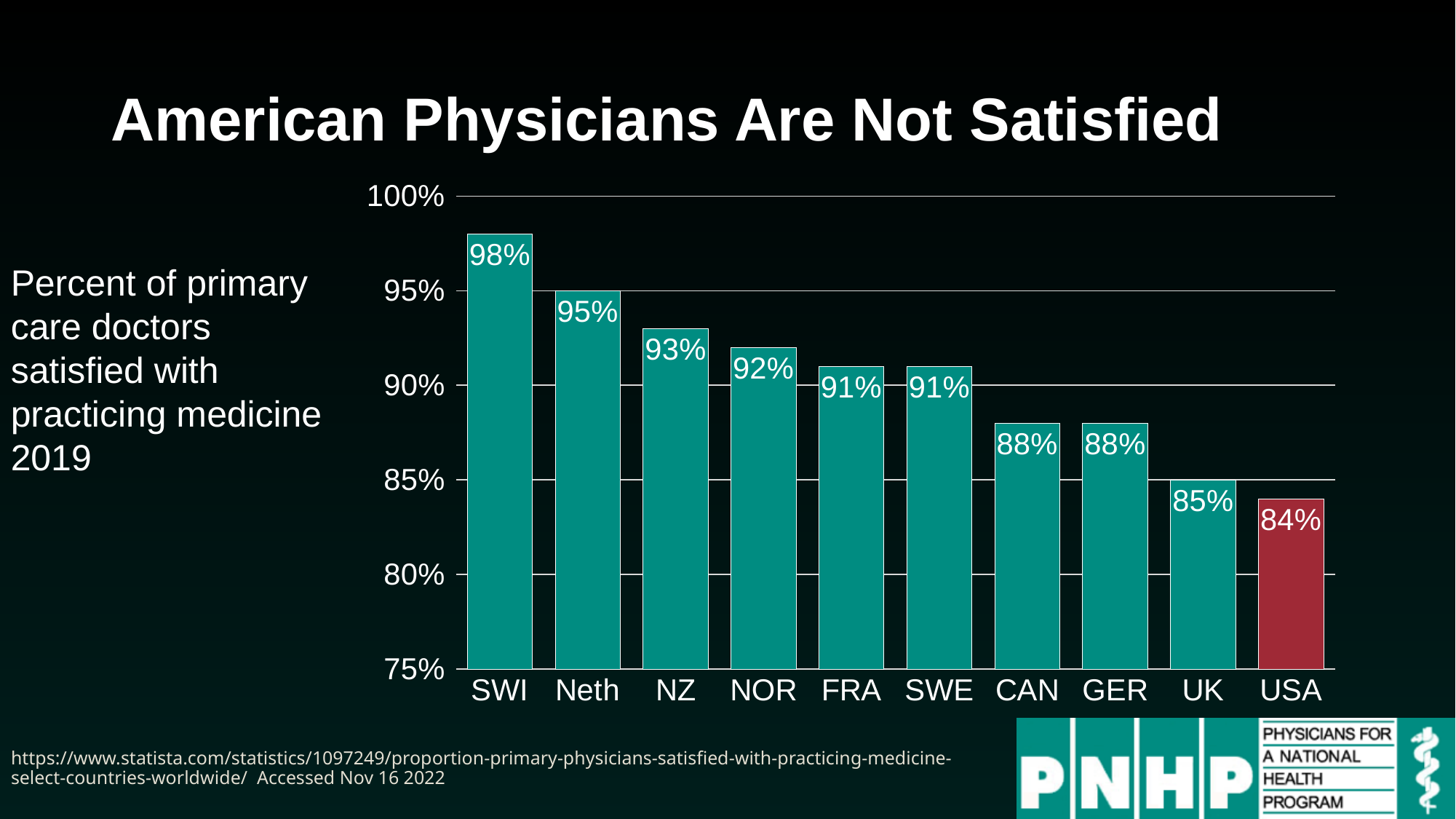
What is the difference between the values for Neth and UK? 10% Which has a higher value, NZ or GER? NZ What is the difference between the values for SWI and the USA? 14% Which country has the lowest percentage of satisfied primary care doctors? USA How many countries are shown in the chart? 10 What is the value shown for the USA? 84% What kind of chart is shown on the slide? Bar chart Which bar is coloured differently (red) from the others? USA Which country has the highest percentage of satisfied primary care doctors? SWI What percentage of primary care doctors in SWI are satisfied with practicing medicine? 98% What is the value shown for CAN? 88% Do the values rise or fall from left to right across the x axis? Fall